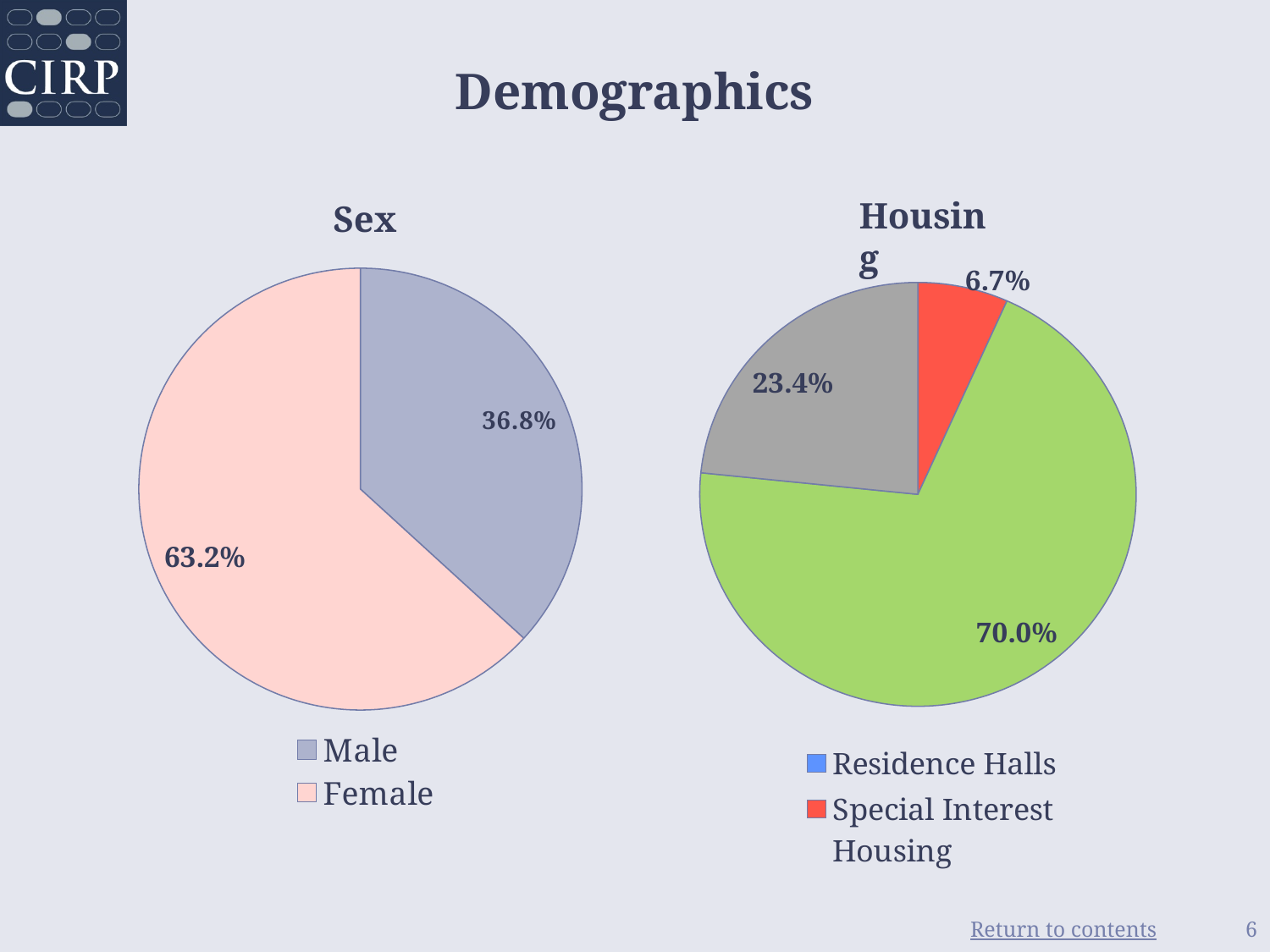
In the Sex chart, what is the difference between the Female and Male percentages? 26.4% In the Housing chart, what is the difference between the 70.0% slice and the 23.4% slice? 46.6% In the Housing chart, which category has the smallest slice? Special Interest Housing What kind of chart is the Housing chart? Pie chart In the Sex chart, which slice is larger, Male or Female? Female In the Housing chart, what is the value of the largest slice? 70.0% How many entries does the legend of the Sex chart list? 2 In the Housing chart, what percentage is Special Interest Housing? 6.7% In the Sex chart, what percentage is Female? 63.2% What kind of chart is the Sex chart? Pie chart How many slices does the Housing pie chart have? 3 In the Sex chart, what percentage is Male? 36.8%